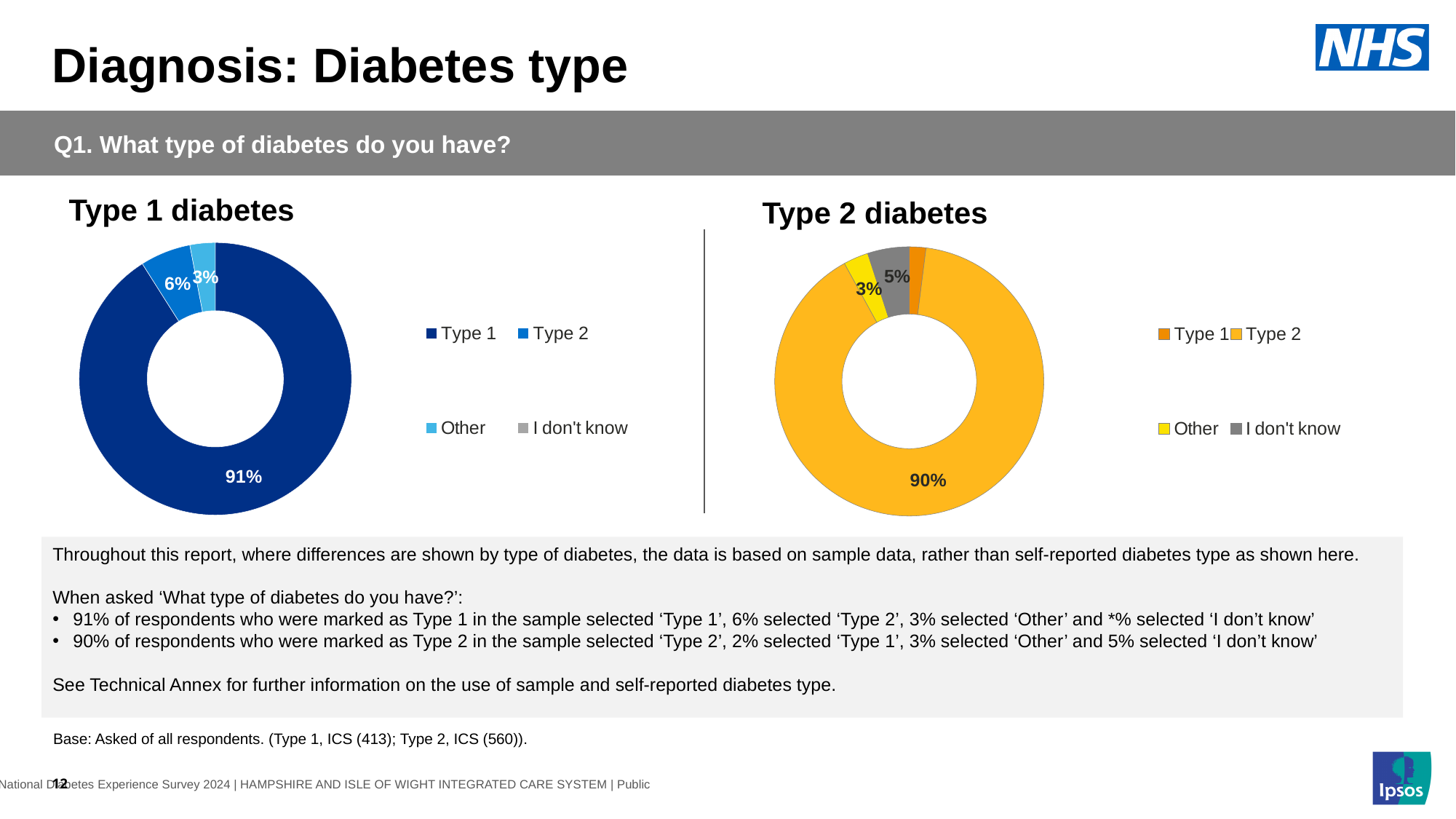
In the 'Type 2 diabetes' chart, what share of respondents selected 'Type 2'? 90% What kind of chart is the 'Type 1 diabetes' chart? Doughnut (pie) chart How many entries does the legend of the 'Type 2 diabetes' chart list? 4 In the 'Type 1 diabetes' chart, what share of respondents selected 'Other'? 3% In the 'Type 2 diabetes' chart, which category has the largest slice? Type 2 In the 'Type 2 diabetes' chart, is the 'I don't know' slice larger or smaller than the 'Other' slice? Larger In the 'Type 1 diabetes' chart, what share of respondents selected 'Type 1'? 91% In the 'Type 2 diabetes' chart, what share of respondents selected 'Other'? 3% In the 'Type 1 diabetes' chart, which category has the largest slice? Type 1 In the 'Type 1 diabetes' chart, what is the difference between the 'Type 1' and 'Type 2' shares? 85 percentage points In the 'Type 1 diabetes' chart, what share of respondents selected 'Type 2'? 6% In the 'Type 2 diabetes' chart, what share of respondents selected 'I don't know'? 5%